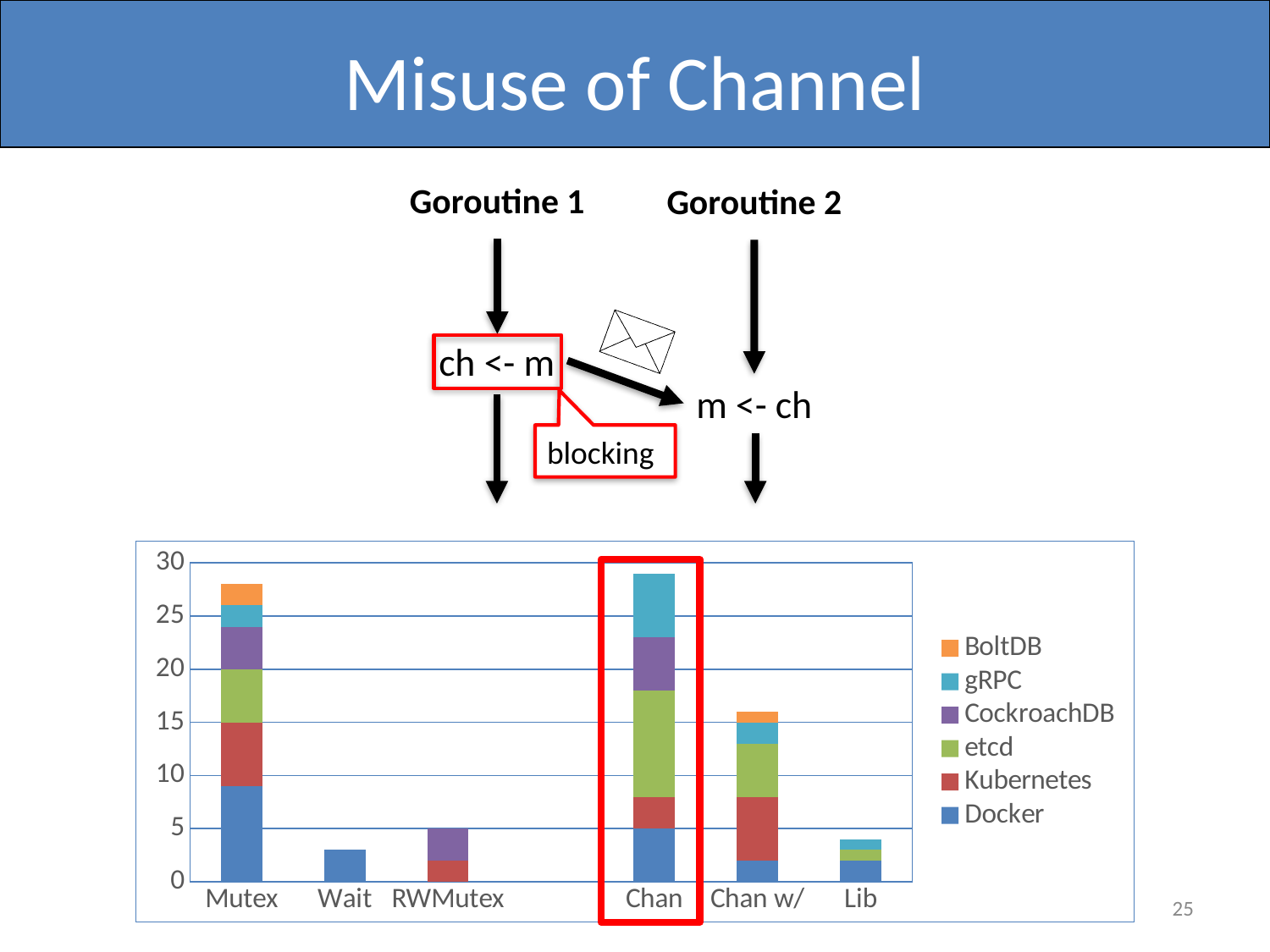
Which bar is taller, Chan w/ or Lib? Chan w/ Which bar is taller, Mutex or Wait? Mutex Is the total value of the Chan w/ bar greater or less than 20? less How many series does the chart's legend list? 6 Is the total value of the Mutex bar greater or less than 25? greater Is the total value of the Chan bar greater or less than 25? greater Which category's bar is highlighted with a red box on the chart? Chan Which colour represents Docker in the chart's legend? blue What kind of chart is shown on the slide? stacked bar chart